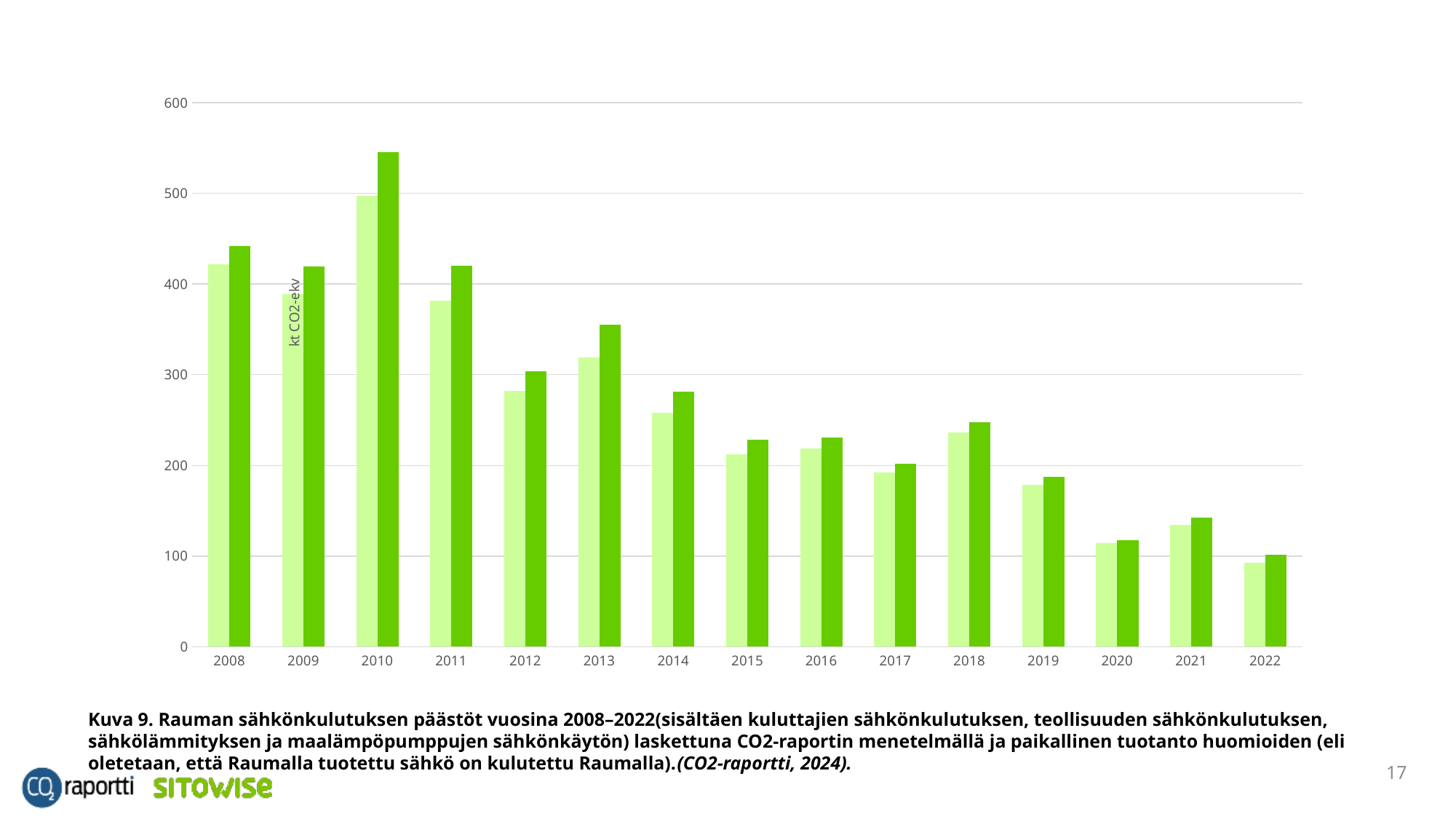
Which is larger, the dark green bar for 2008 or the dark green bar for 2010? 2010 Is the dark green bar for 2013 greater or less than 300? greater Which year has the shortest bar in the chart? 2022 Do the values generally rise or fall from 2008 to 2022? fall What unit is written on the vertical axis of the chart? kt CO2-ekv Which year has the tallest bar in the chart? 2010 Is the dark green bar for 2010 greater or less than 500? greater Which is larger, the dark green bar for 2014 or the dark green bar for 2015? 2014 Is the light green bar for 2012 greater or less than 300? less What kind of chart is shown on the slide? bar chart How many years are shown on the x axis of the chart? 15